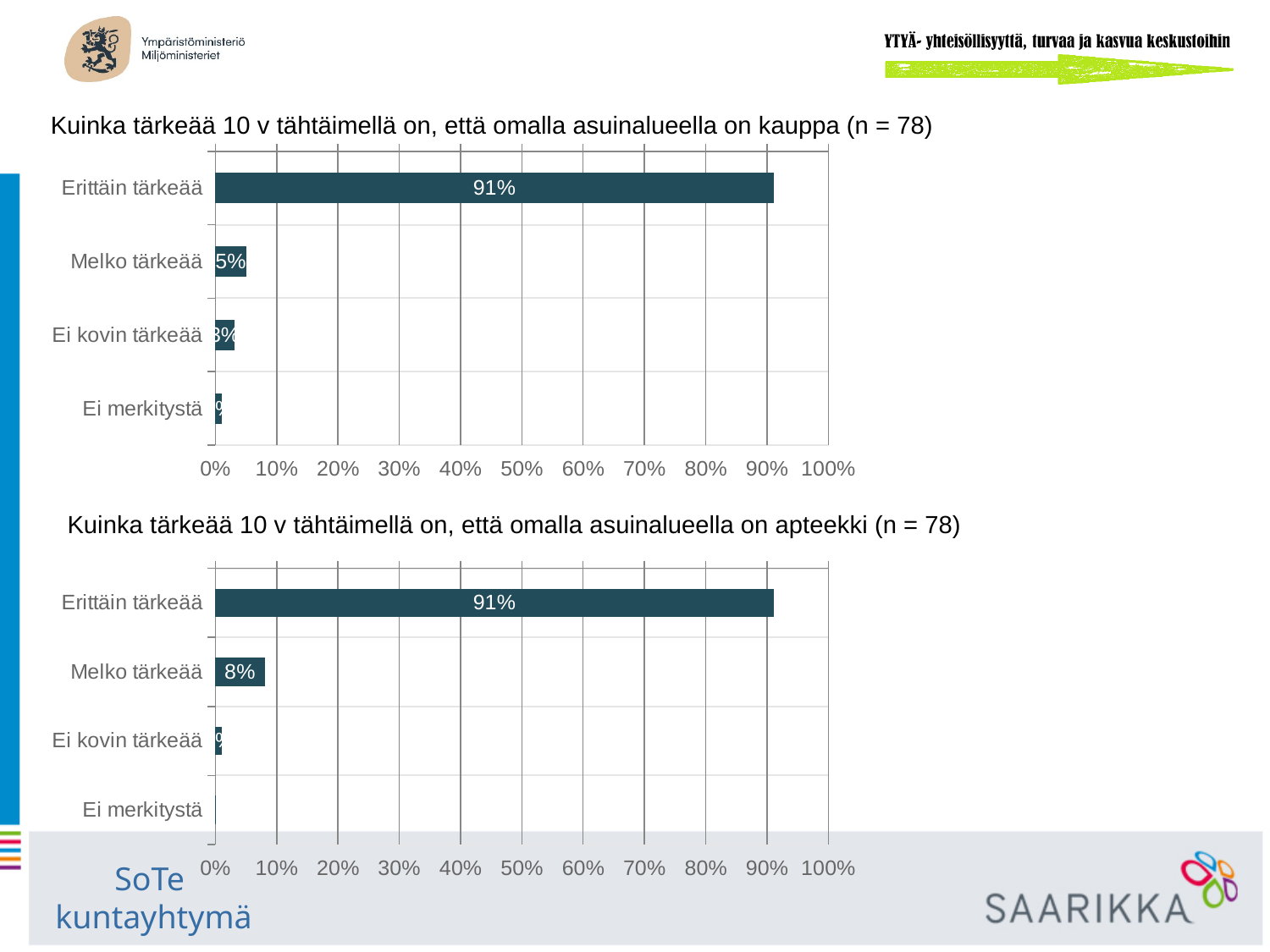
In the top chart (kauppa), what is the difference between "Erittäin tärkeää" and "Melko tärkeää"? 86 percentage points In the top chart (kauppa), which category has the highest value? Erittäin tärkeää What type of chart is the top chart (kauppa)? bar chart In the bottom chart (apteekki), which category has the lowest value? Ei merkitystä In the bottom chart (apteekki), what is the difference between "Erittäin tärkeää" and "Melko tärkeää"? 83 percentage points In the top chart (kauppa), what is the value for "Melko tärkeää"? 5% In the bottom chart (apteekki), what is the value for "Erittäin tärkeää"? 91% In the top chart (kauppa), is the value for "Ei kovin tärkeää" greater or less than 10%? less How many categories are shown in the bottom chart (apteekki)? 4 Is the value for "Melko tärkeää" larger in the top chart (kauppa) or the bottom chart (apteekki)? bottom chart (apteekki) In the top chart (kauppa), what percentage of respondents answered "Erittäin tärkeää"? 91% In the bottom chart (apteekki), what is the value for "Melko tärkeää"? 8%